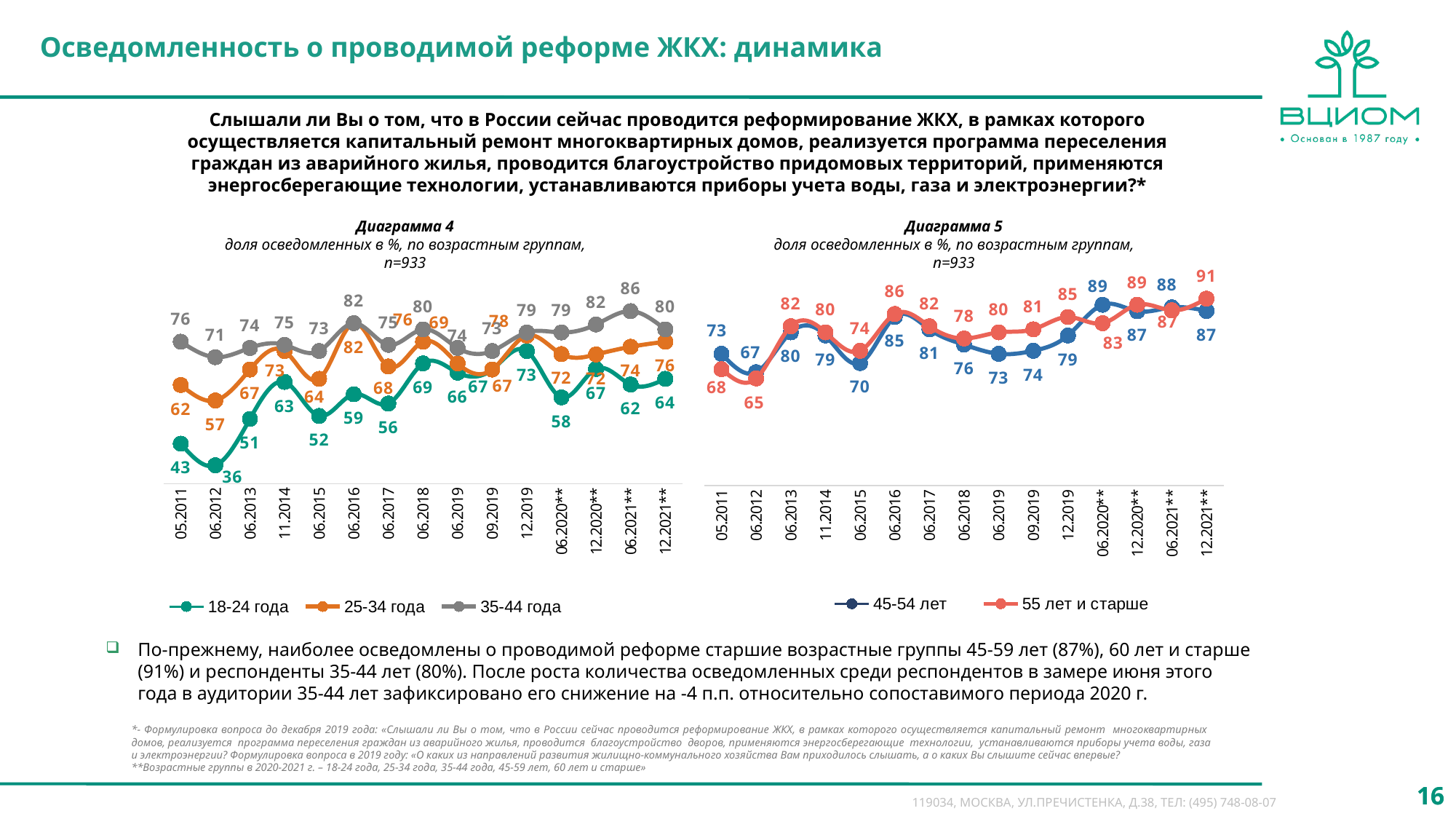
On Диаграмма 4, at which date does the 18-24 года series reach its lowest value? 06.2012 On Диаграмма 5, how many dates are shown on the x axis? 15 On Диаграмма 5, at which date does the 55 лет и старше series reach its lowest value? 06.2012 On Диаграмма 5, what is the value for the 45-54 лет series at 06.2015? 70 On Диаграмма 5, what is the value for the 55 лет и старше series at 12.2021**? 91 On Диаграмма 4, what is the value for the 18-24 года series at 06.2012? 36 On Диаграмма 4, how many series does the legend list? 3 What type of chart is Диаграмма 4? Line chart On Диаграмма 4, what is the difference between the 35-44 года and 18-24 года values at 12.2021**? 16 On Диаграмма 4, what is the value for the 25-34 года series at 12.2021**? 76 On Диаграмма 5, which series has the higher value at 06.2020**: 45-54 лет or 55 лет и старше? 45-54 лет On Диаграмма 4, what is the value for the 35-44 года series at 06.2021**? 86